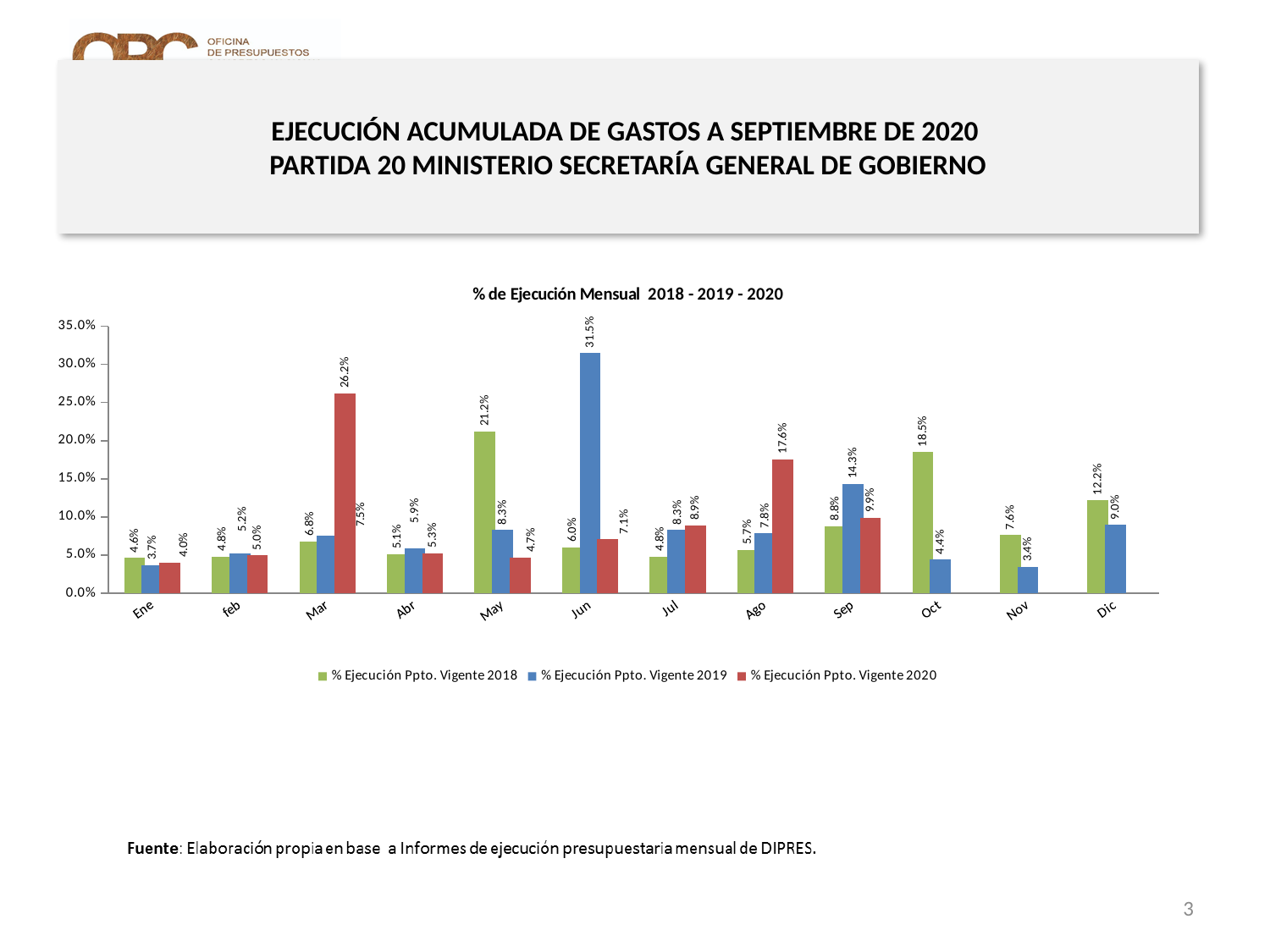
How many series does the legend list? 3 Which is larger in Oct: the 2018 value or the 2019 value? 2018 What is the value for % Ejecución Ppto. Vigente 2020 in Mar? 26.2% What is the value for % Ejecución Ppto. Vigente 2019 in Jun? 31.5% What is the value for % Ejecución Ppto. Vigente 2020 in Ago? 17.6% What kind of chart is shown on the slide? Bar chart Is the value for % Ejecución Ppto. Vigente 2019 in Jun greater or less than 30.0%? greater What is the difference between the 2019 and 2018 values in Sep? 5.5% What is the value for % Ejecución Ppto. Vigente 2018 in May? 21.2% In which month is the % Ejecución Ppto. Vigente 2019 series lowest? Nov How many months are shown on the x axis? 12 In which month is the % Ejecución Ppto. Vigente 2018 series highest? May